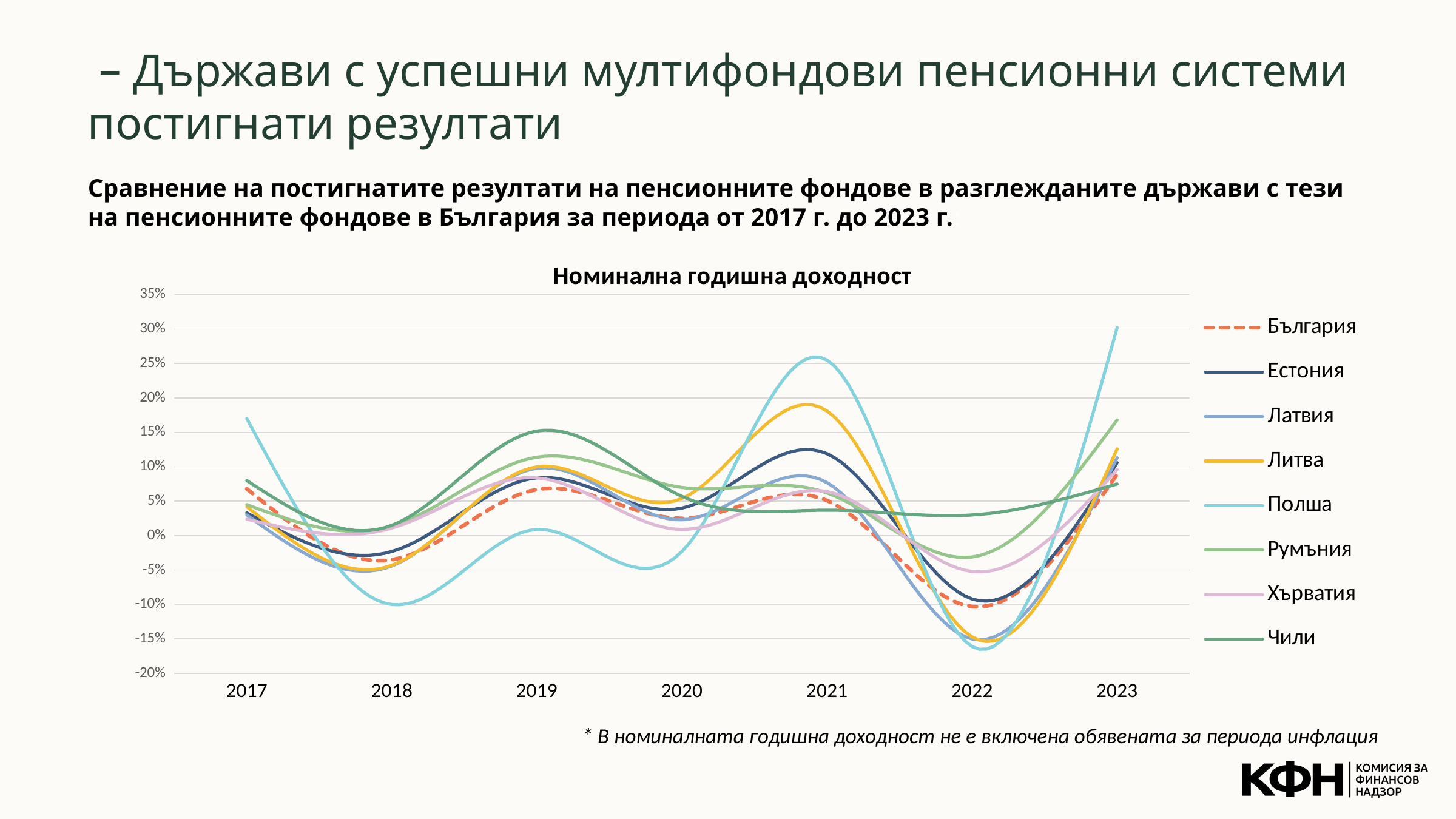
What is the title of the chart? Номинална годишна доходност How many years are shown on the x axis of the chart? 7 Which country has the highest nominal annual return in 2021? Полша How many series does the legend of the chart list? 8 Is the value for България in 2022 greater or less than -5%? less In 2019, which is larger: the value for Чили or the value for България? Чили What kind of chart is shown on the slide? line chart Which series is drawn with a dashed line in the chart? България Is the value for Чили in 2019 greater or less than 10%? greater Is the value for Полша in 2023 greater or less than 25%? greater Which country has the highest nominal annual return in 2023? Полша Which country has the lowest nominal annual return in 2018? Полша